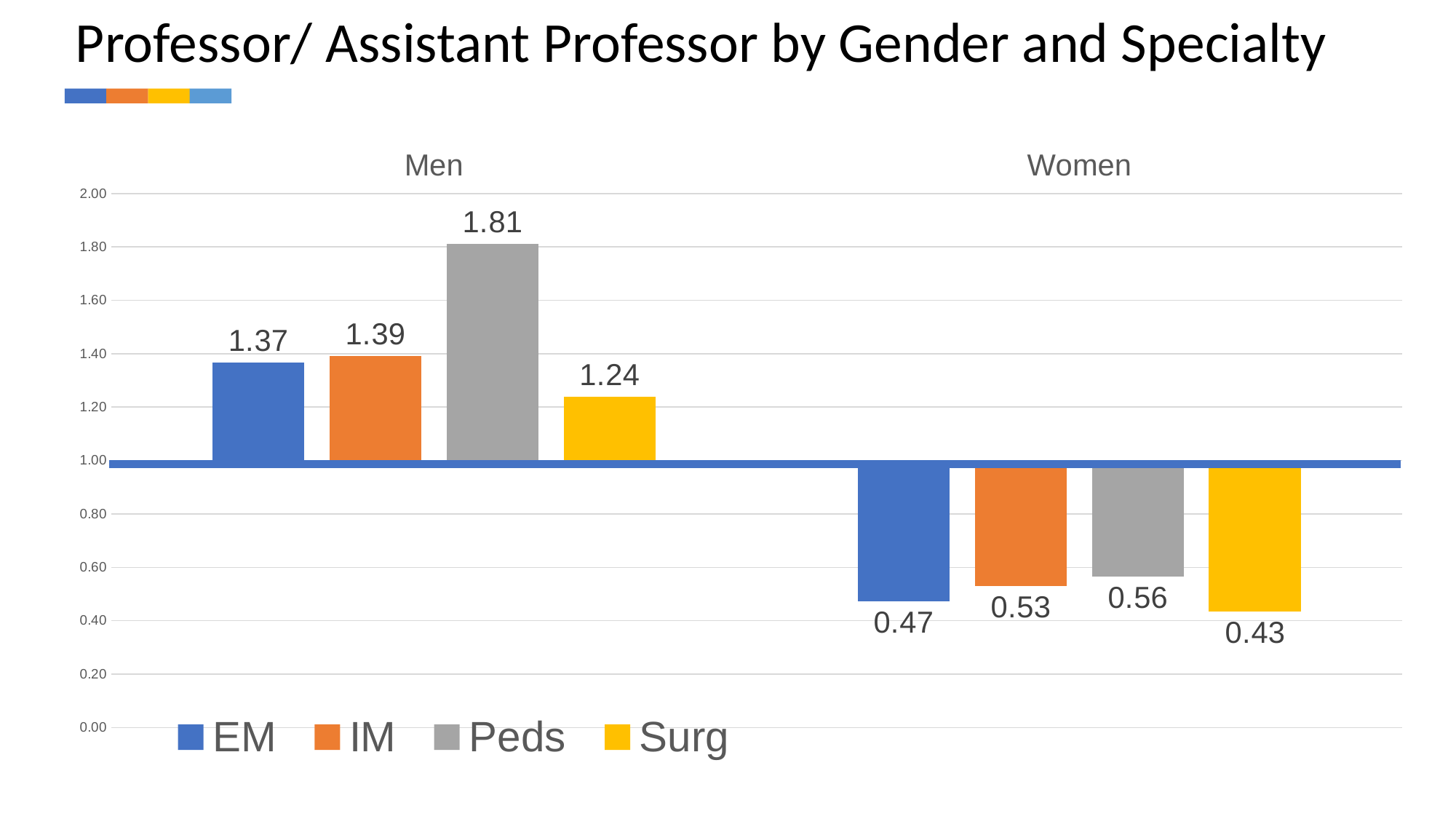
How many series does the legend list? 4 Which specialty has the highest value among Men? Peds What is the value for Surg among Women? 0.43 What is the value for Peds among Men? 1.81 Which is larger, the Surg value for Men or the EM value for Men? EM value for Men What is the value for IM among Women? 0.53 Is the value for Peds among Men greater or less than 1.60? greater Which specialty has the lowest value among Women? Surg What is the value for EM among Men? 1.37 What is the difference between the Peds value for Men and the Peds value for Women? 1.25 What is the title of the chart? Professor/ Assistant Professor by Gender and Specialty What kind of chart is shown on the slide? Bar chart